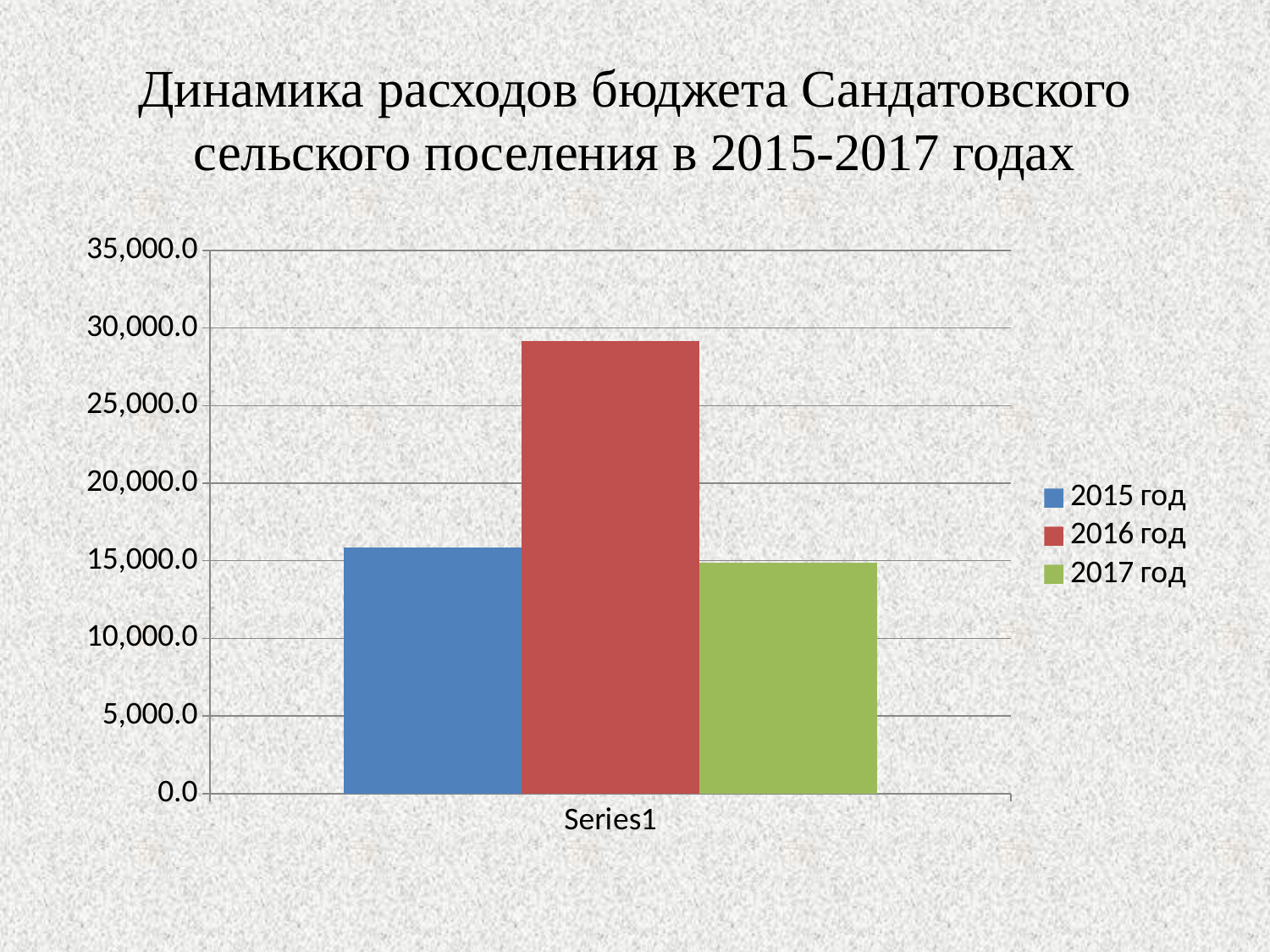
What colour is the bar for 2016 год? red What is the title of the chart? Динамика расходов бюджета Сандатовского сельского поселения в 2015-2017 годах Is the value for 2016 год greater or less than 25,000.0? greater What kind of chart is shown on the slide? bar chart Is the value for 2015 год greater or less than 20,000.0? less Which year has the highest bar? 2016 год Which is larger, the value for 2016 год or the value for 2015 год? 2016 год Which year has the lowest bar? 2017 год Which is larger, the value for 2016 год or the value for 2017 год? 2016 год How many series does the legend list? 3 Is the value for 2017 год greater or less than 10,000.0? greater